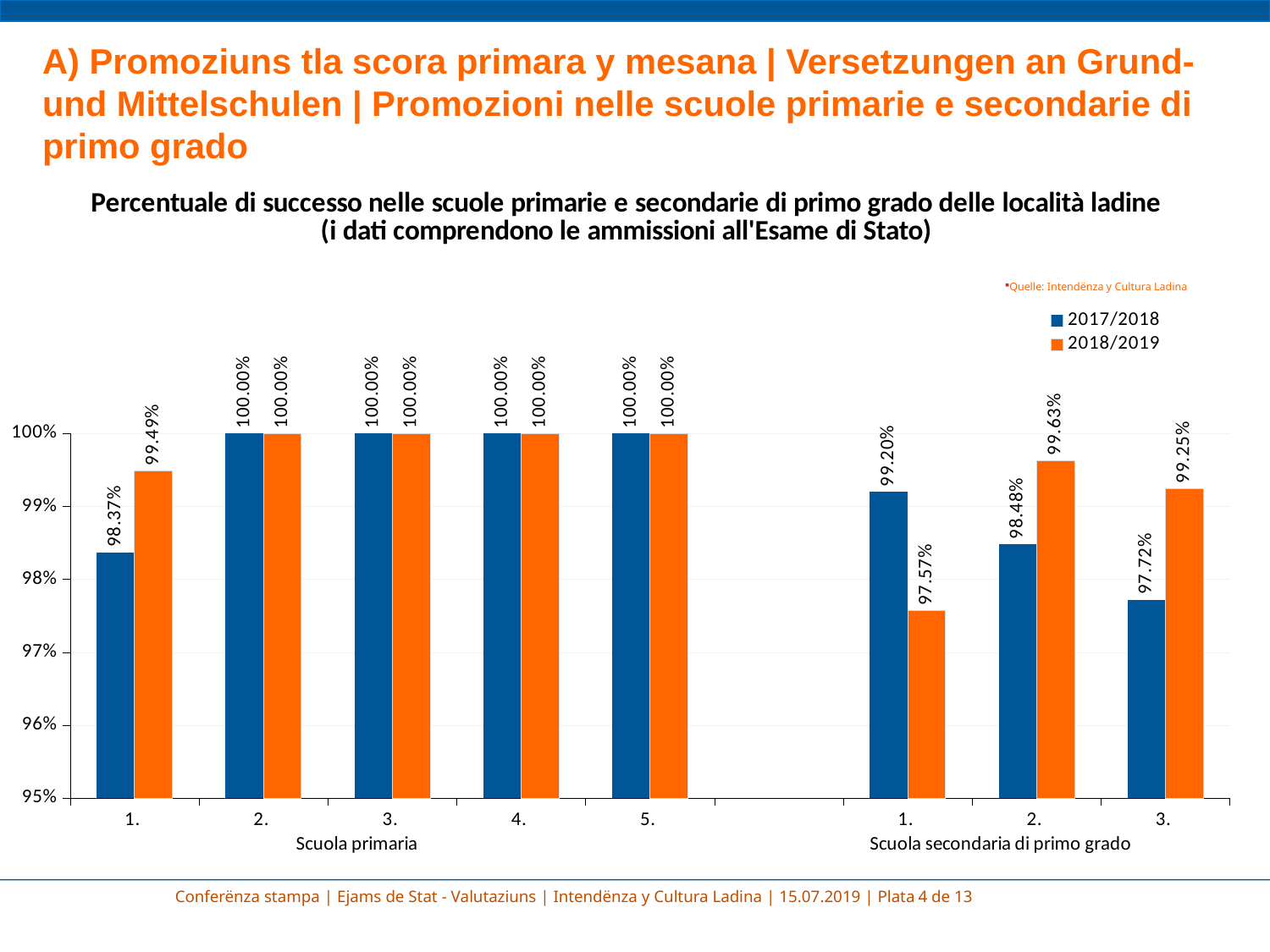
What is the difference between the 2018/2019 and 2017/2018 values for class 1 of Scuola primaria? 1.12% For class 1 of Scuola secondaria di primo grado, which series has the larger value, 2017/2018 or 2018/2019? 2017/2018 What kind of chart is shown on the slide? Bar chart What is the value for 2017/2018 for class 1 of Scuola primaria? 98.37% Which class has the lowest 2018/2019 value? 1. Scuola secondaria di primo grado What is the value for 2018/2019 for class 3 of Scuola secondaria di primo grado? 99.25% How many series does the legend list? 2 Which colour represents the 2018/2019 series? Orange What is the value for 2017/2018 for class 2 of Scuola secondaria di primo grado? 98.48% What is the value for 2018/2019 for class 1 of Scuola secondaria di primo grado? 97.57% Which class has the lowest 2017/2018 value? 3. Scuola secondaria di primo grado What is the value for 2018/2019 for class 1 of Scuola primaria? 99.49%